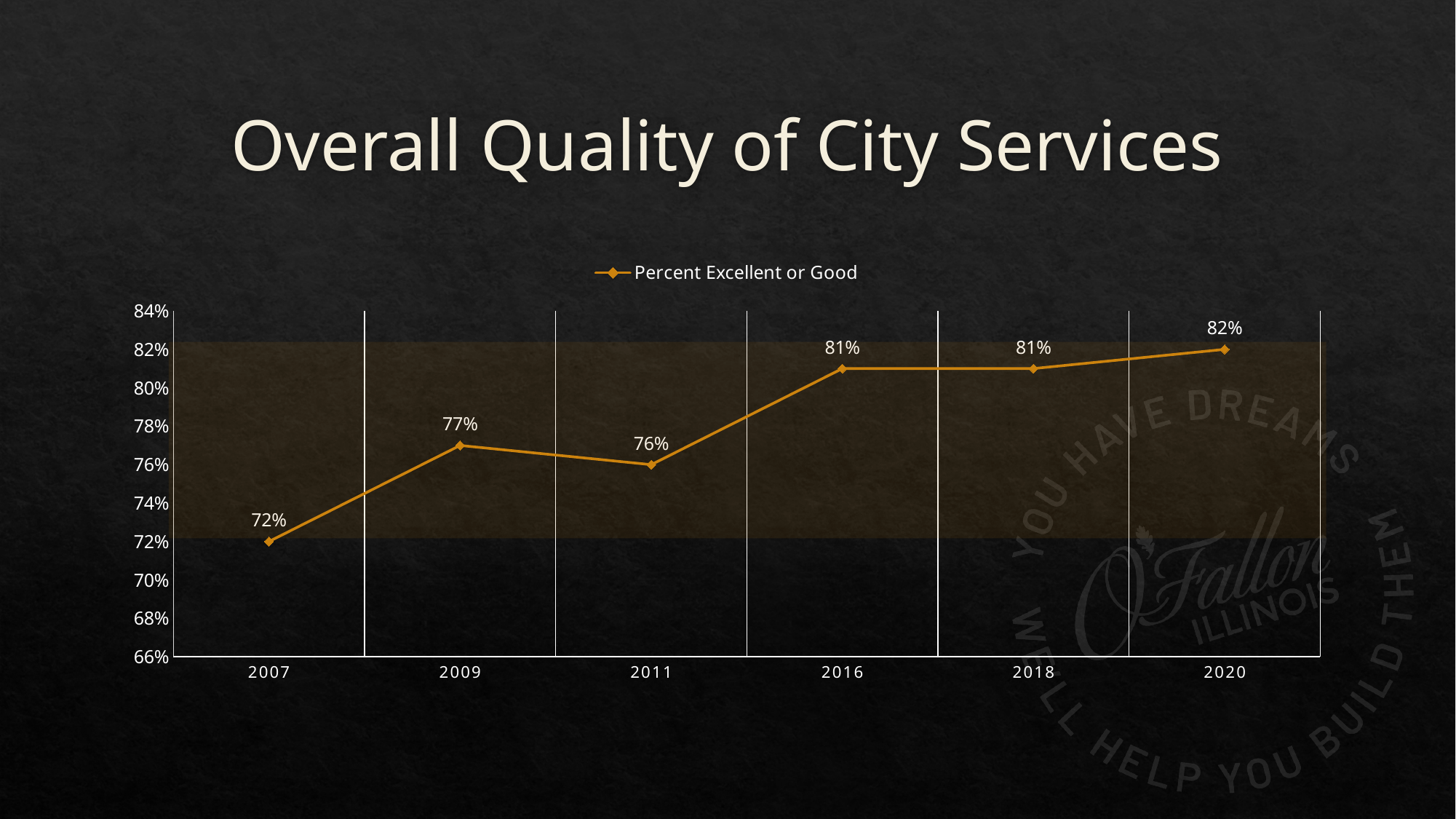
How many series does the legend list? 1 Which year has the highest value? 2020 What is the value for 2007? 72% What is the value for 2020? 82% Which year has the lowest value? 2007 What is the value for 2011? 76% What is the difference between the values for 2020 and 2007? 10% Is the value for 2016 greater or less than 80%? greater How many years are plotted on the x axis? 6 What is the title of the chart? Overall Quality of City Services Which is larger, the value for 2009 or the value for 2011? 2009 What kind of chart is shown? line chart